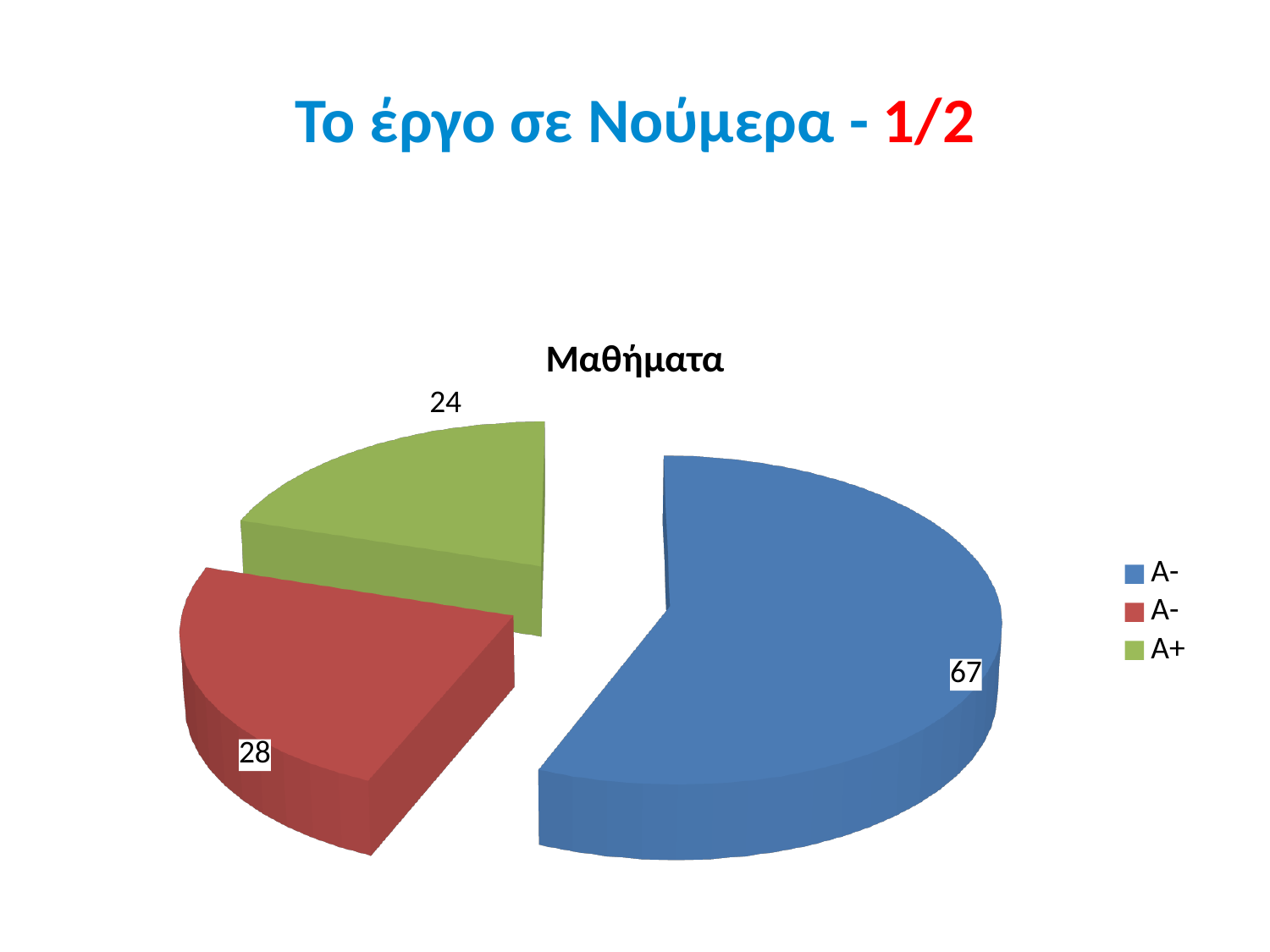
What is the title of the chart? Μαθήματα Which slice is the smallest? A+ (24) What is the value of the A+ slice? 24 What is the total of all three slices? 119 Which is larger, the red slice or the green A+ slice? the red slice (28) How many entries does the legend list? 3 Which slice is the largest? the blue slice (67) What is the value of the red slice? 28 How many slices does the pie chart have? 3 What kind of chart is shown on the slide? pie chart What is the difference between the blue slice and the red slice? 39 What is the value of the blue slice? 67